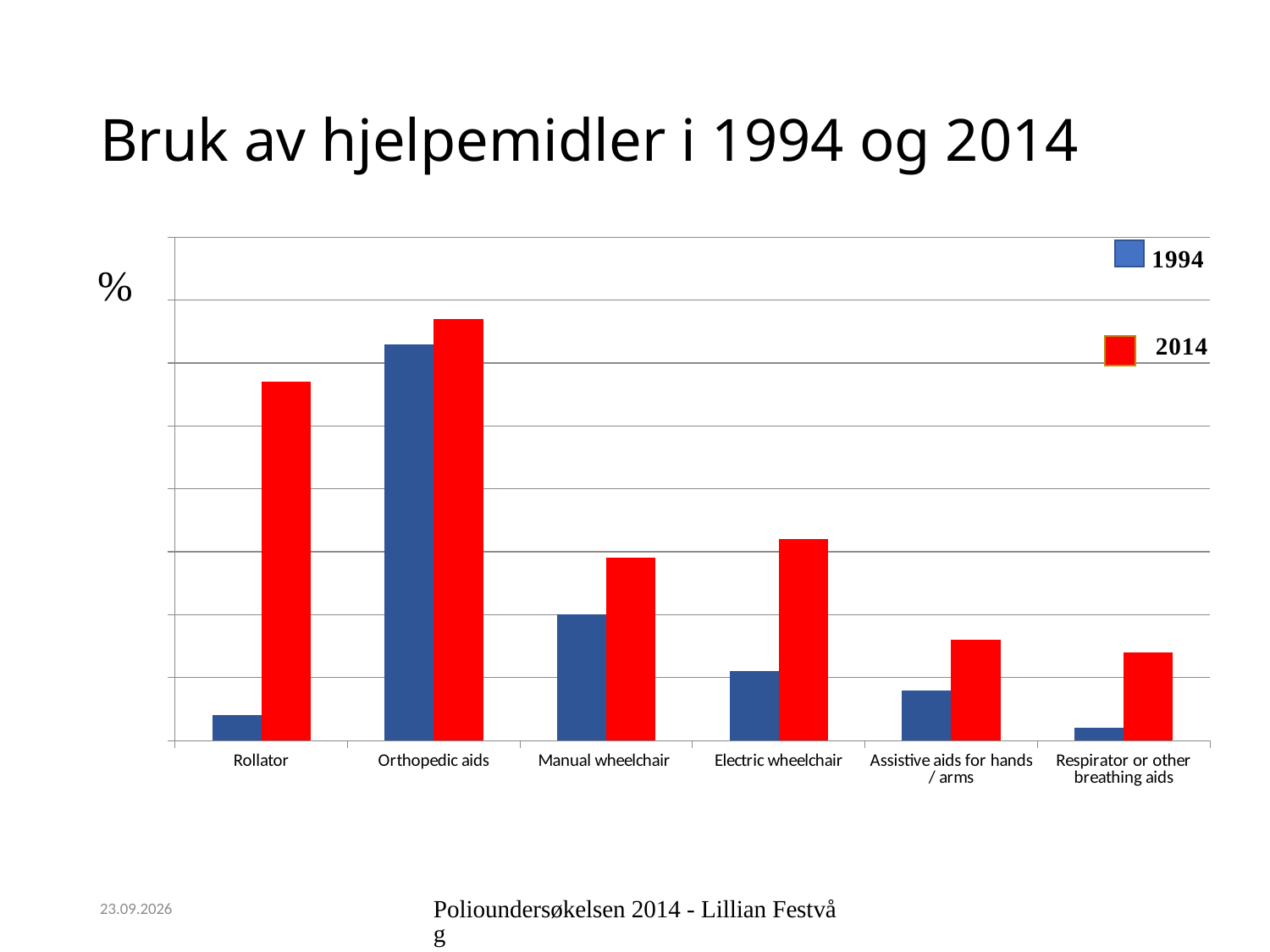
Which colour represents the 2014 series in the legend? Red How many series does the legend list? 2 Which category has the lowest value for 1994? Respirator or other breathing aids Which is larger: the 1994 value for Orthopedic aids or the 2014 value for Rollator? Orthopedic aids (1994) For Rollator, which year has the larger value, 1994 or 2014? 2014 Which is larger: the 2014 value for Electric wheelchair or the 2014 value for Manual wheelchair? Electric wheelchair What kind of chart is shown on the slide? Bar chart Which category has the highest value for 1994? Orthopedic aids How many categories are shown on the x axis? 6 Which category has the highest value for 2014? Orthopedic aids What is the title of the slide containing the chart? Bruk av hjelpemidler i 1994 og 2014